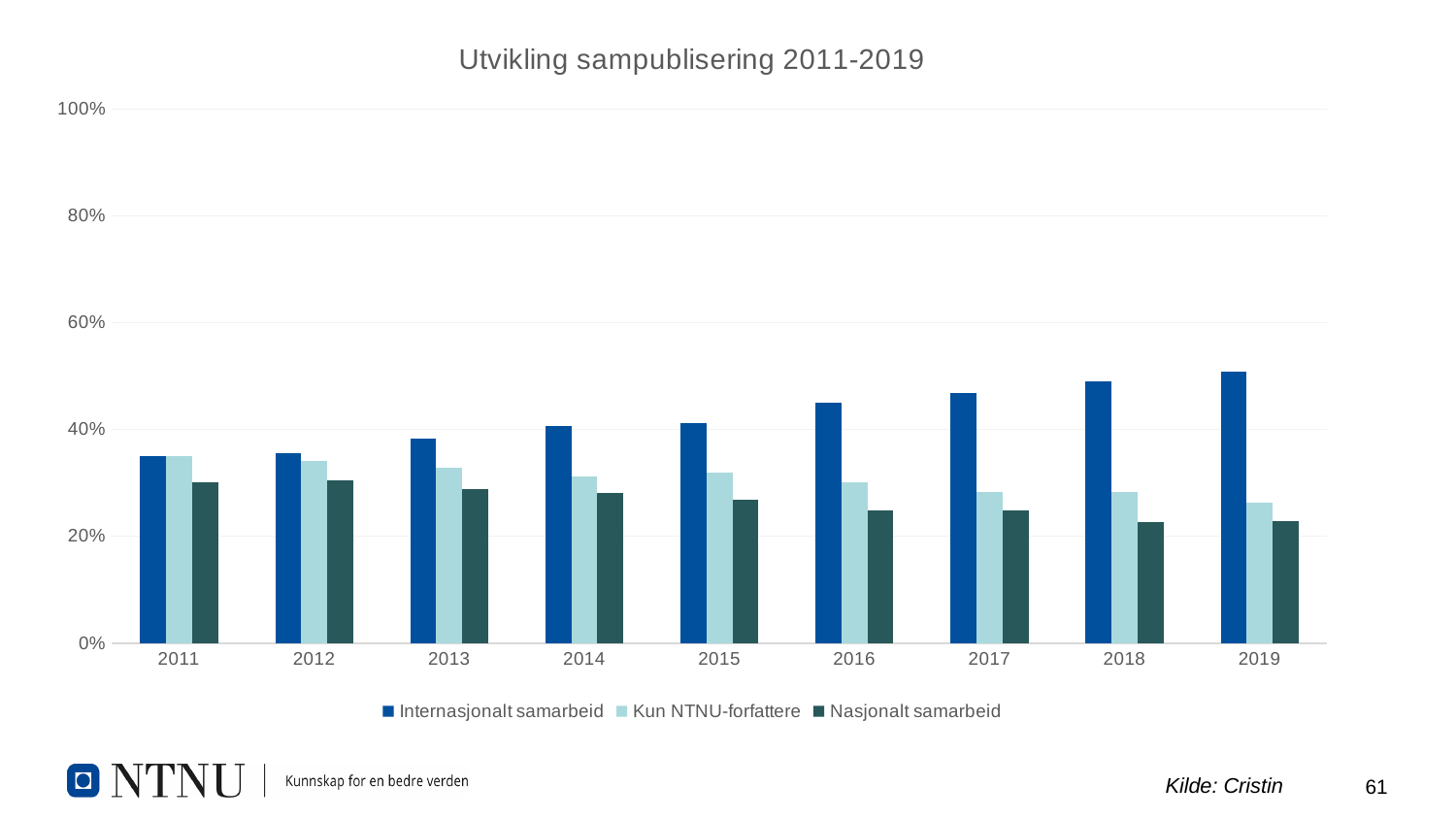
What is the title of the chart? Utvikling sampublisering 2011-2019 In which year is Kun NTNU-forfattere lowest? 2019 Is the value for Internasjonalt samarbeid in 2019 greater or less than 60%? less Is the value for Nasjonalt samarbeid in 2018 greater or less than 40%? less Does the value for Internasjonalt samarbeid rise or fall from 2011 to 2019? Rise How many series does the legend list? 3 In which year is Internasjonalt samarbeid highest? 2019 What kind of chart is shown on the slide? Bar chart How many years are shown on the x axis? 9 Is the value for Internasjonalt samarbeid in 2019 greater or less than 40%? greater In 2019, which is larger: Internasjonalt samarbeid or Kun NTNU-forfattere? Internasjonalt samarbeid Does the value for Nasjonalt samarbeid rise or fall from 2011 to 2019? Fall